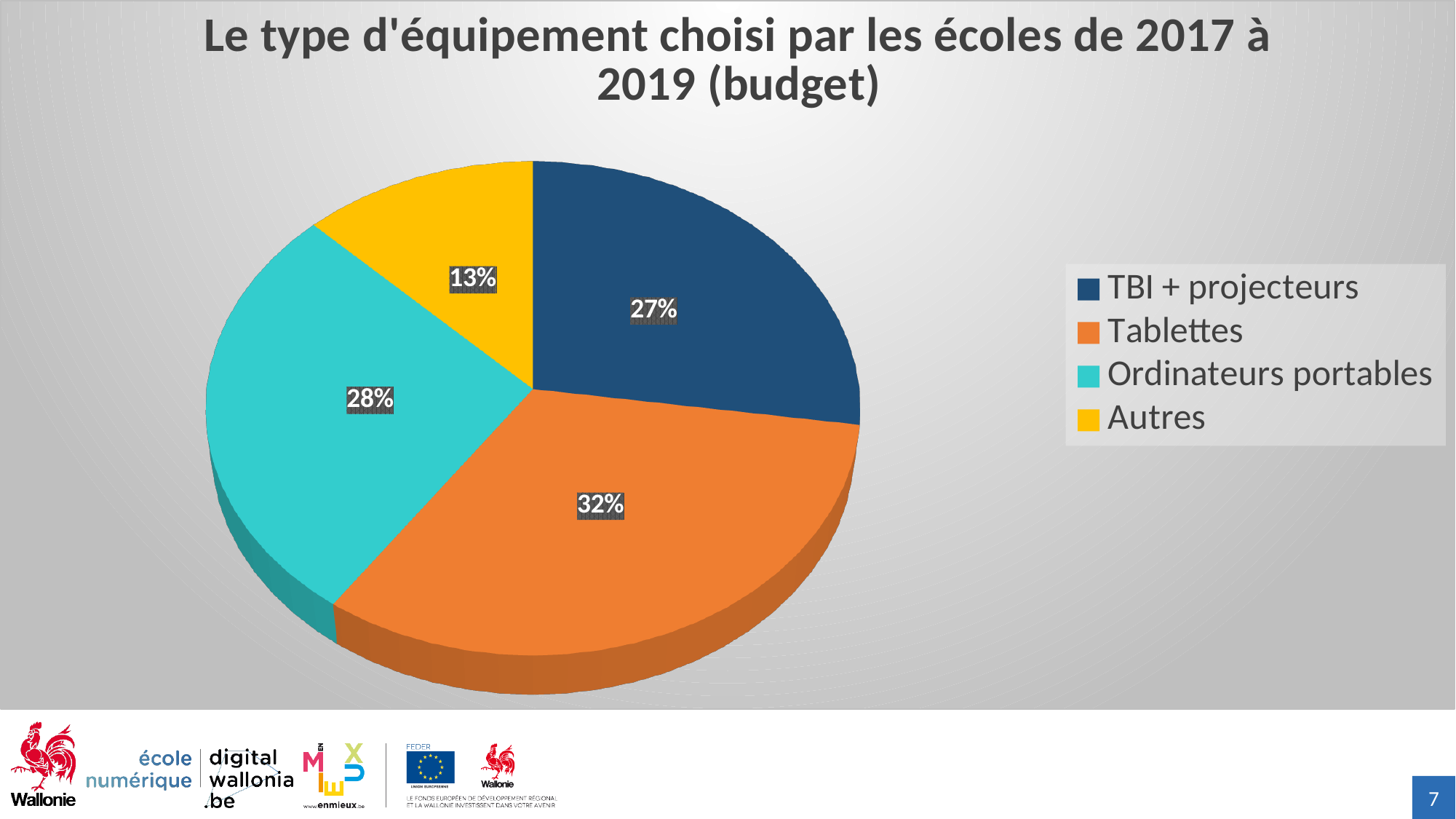
What is the value shown for Autres? 13% What is the difference in percentage points between Ordinateurs portables and TBI + projecteurs? 1 What is the value shown for Ordinateurs portables? 28% Which category has the smallest slice of the pie? Autres Which category has the largest slice of the pie? Tablettes What share of the pie does Tablettes represent? 32% What is the difference in percentage points between Tablettes and Autres? 19 What is the title of the chart? Le type d'équipement choisi par les écoles de 2017 à 2019 (budget) What kind of chart is shown on the slide? Pie chart How many slices does the pie chart have? 4 What is the value shown for TBI + projecteurs? 27% Which is larger, the share for Tablettes or the share for TBI + projecteurs? Tablettes